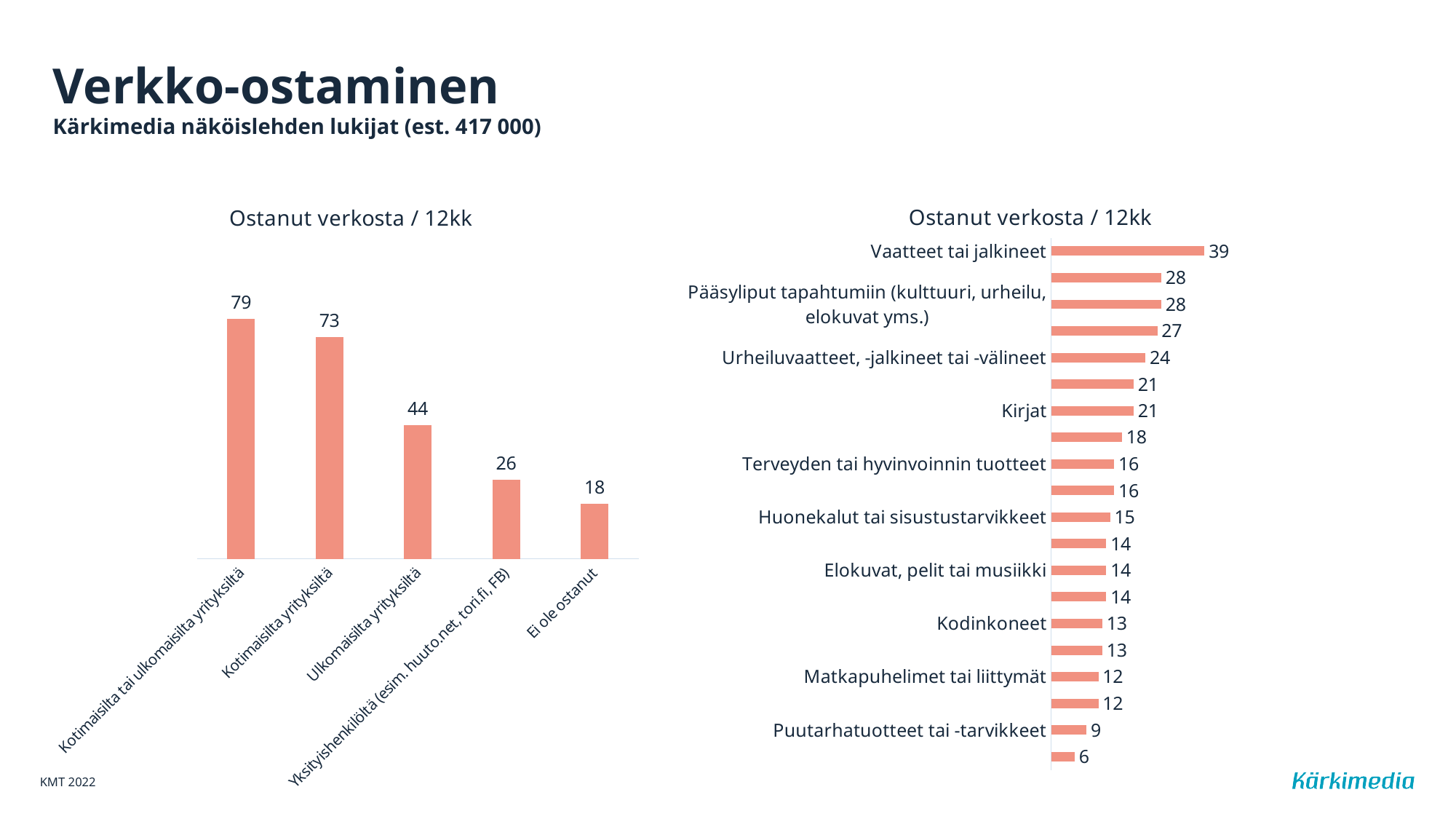
What type of chart is the right chart? bar chart In the left chart, which category has the lowest value? Ei ole ostanut In the right chart, which is larger: Urheiluvaatteet, -jalkineet tai -välineet or Kodinkoneet? Urheiluvaatteet, -jalkineet tai -välineet In the right chart, what is the value for Vaatteet tai jalkineet? 39 In the left chart, which category has the highest value? Kotimaisilta tai ulkomaisilta yrityksiltä In the right chart, what is the value for Kirjat? 21 In the right chart, what is the difference between Vaatteet tai jalkineet and Puutarhatuotteet tai -tarvikkeet? 30 In the left chart, what is the value for Kotimaisilta yrityksiltä? 73 In the left chart, what is the difference between Kotimaisilta yrityksiltä and Ulkomaisilta yrityksiltä? 29 In the left chart, do the values rise or fall from left to right? fall In the left chart, how many categories are shown? 5 In the left chart, what is the value for Ei ole ostanut? 18